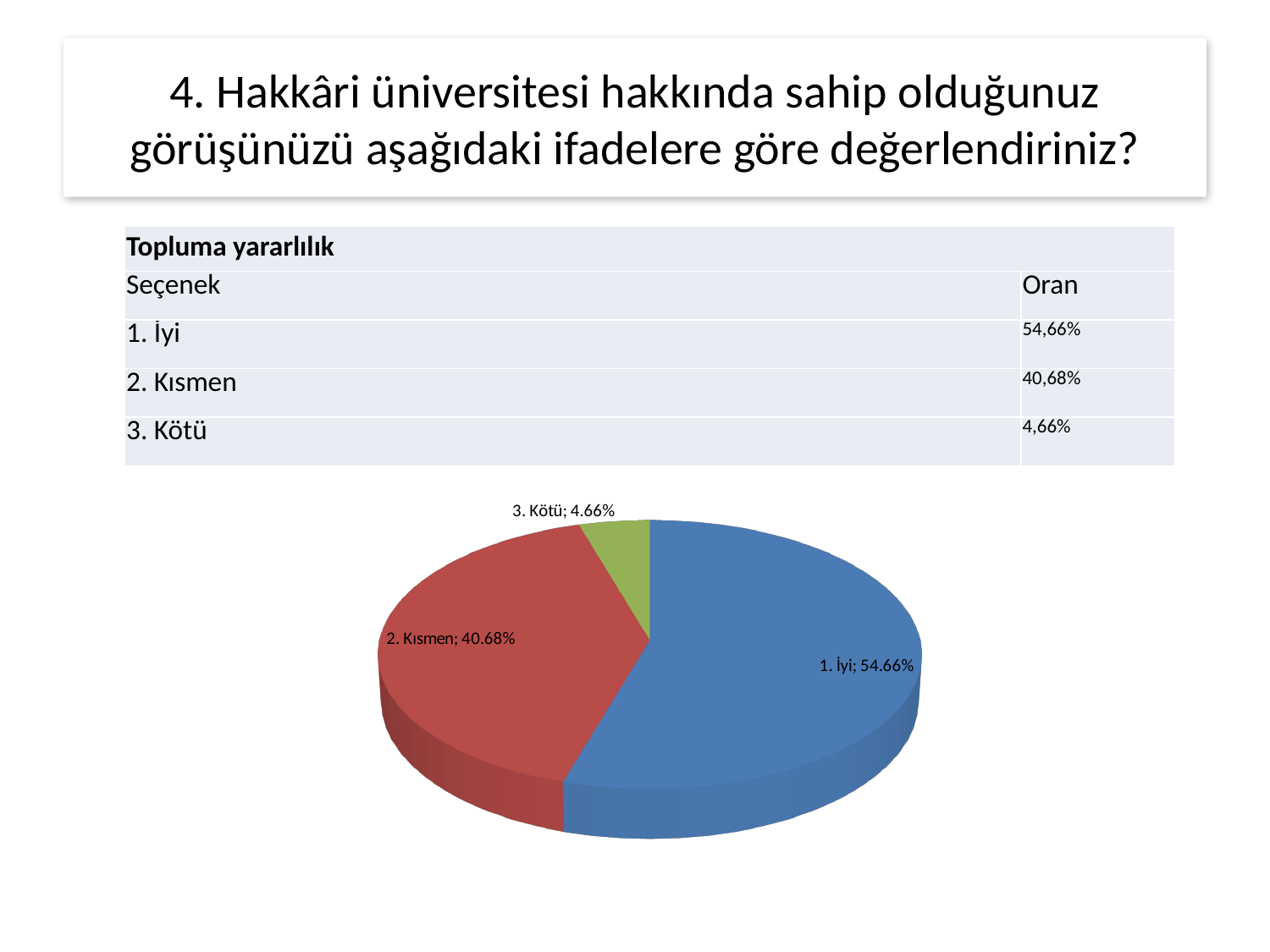
What is the difference between the values for "2. Kısmen" and "3. Kötü" in the pie chart? 36.02% What is the value for the slice labelled "2. Kısmen" in the pie chart? 40.68% Which category has the smallest slice in the pie chart? 3. Kötü What is the value for the slice labelled "3. Kötü" in the pie chart? 4.66% What colour is the "1. İyi" slice in the pie chart? blue Which category has the largest slice in the pie chart? 1. İyi Which is larger in the pie chart, the slice for "2. Kısmen" or the slice for "3. Kötü"? 2. Kısmen How many slices does the pie chart have? 3 What share of the pie does the "3. Kötü" slice represent? 4.66% What is the difference between the values for "1. İyi" and "2. Kısmen" in the pie chart? 13.98% What kind of chart is shown on the slide? pie chart What is the value for the slice labelled "1. İyi" in the pie chart? 54.66%